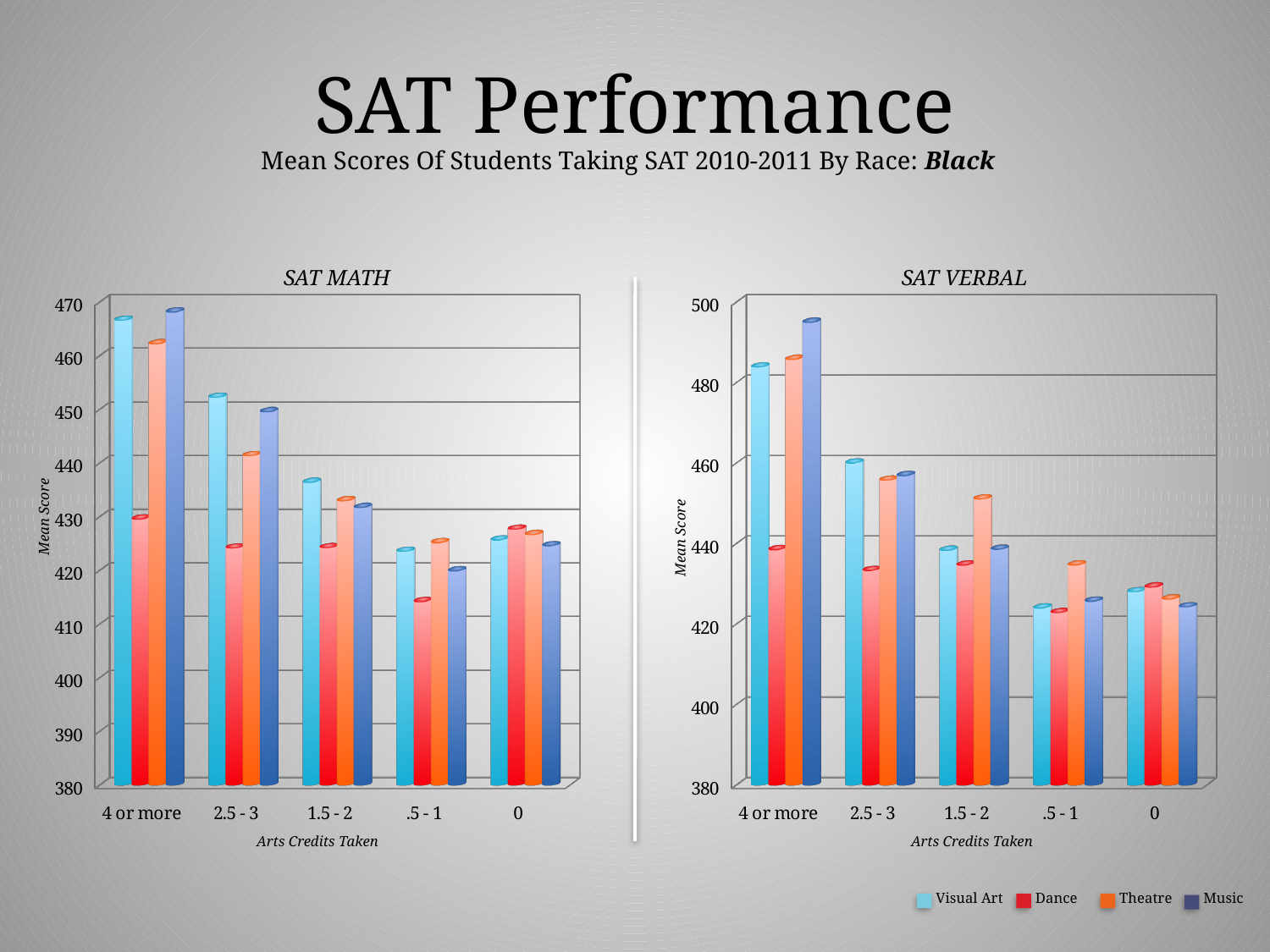
How many series does the legend list? 4 In the SAT VERBAL chart, for '4 or more' credits, which is larger: Music or Dance? Music In the SAT MATH chart, which Arts Credits Taken category has the lowest Dance score? .5 - 1 In the SAT VERBAL chart, is the Music value for '4 or more' greater or less than 480? greater In the SAT VERBAL chart, is the Theatre value for '1.5 - 2' greater or less than 440? greater In the SAT MATH chart, is the Visual Art value for '4 or more' greater or less than 460? greater In the SAT MATH chart, which Arts Credits Taken category has the highest Music score? 4 or more What is the y-axis label on the SAT MATH chart? Mean Score How many Arts Credits Taken categories are shown on the SAT VERBAL chart? 5 What kind of chart is the SAT MATH chart? bar chart In the SAT VERBAL chart, does the Music score rise or fall from '4 or more' to '0' credits? fall